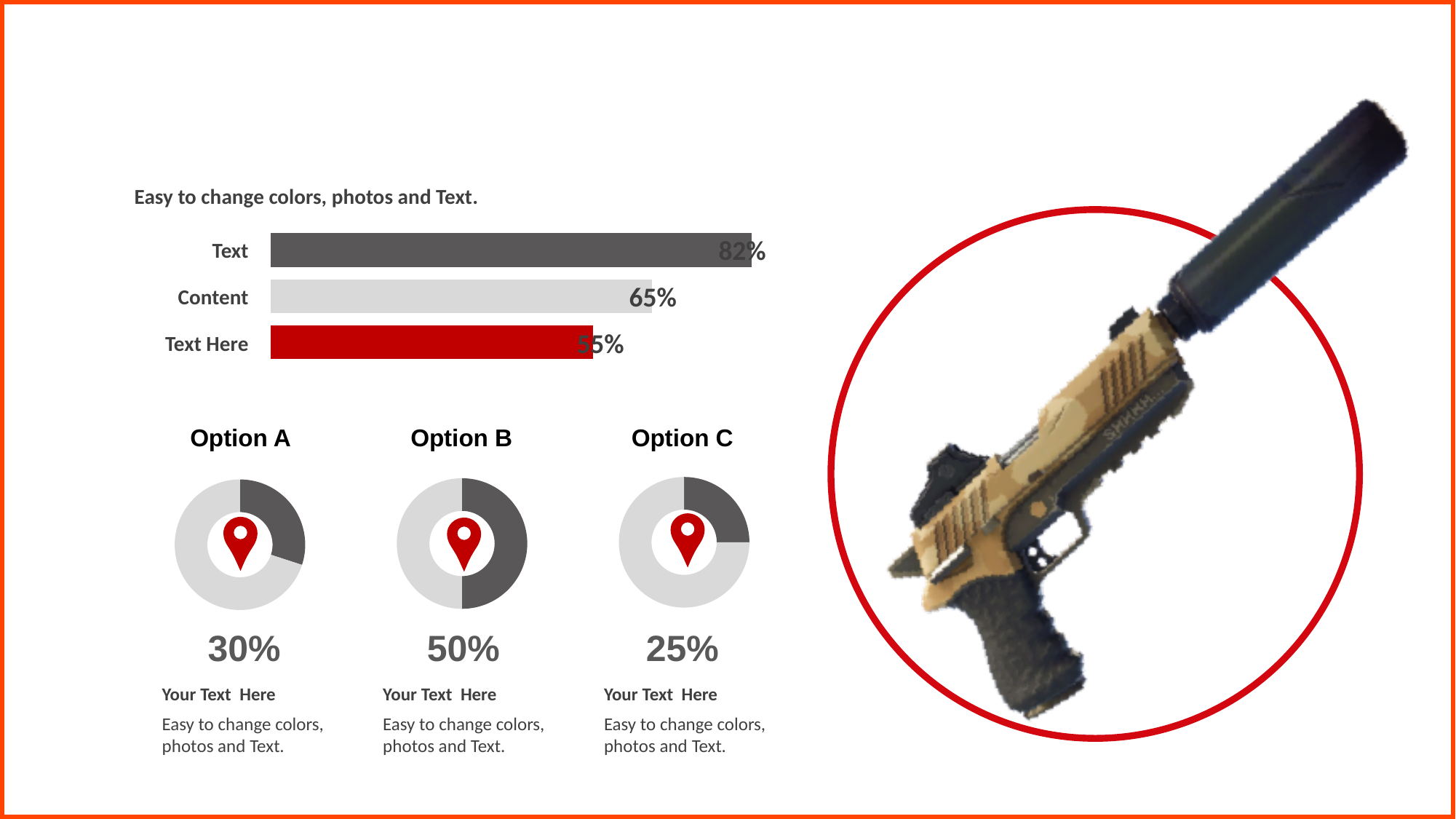
In the horizontal bar chart at the top left, what is the difference between the values for Text and Content? 17% In the horizontal bar chart at the top left, which category has the highest value? Text What percentage is shown for the Option B donut chart? 50% Which of the three donut charts (Option A, Option B, Option C) shows the lowest percentage? Option C In the horizontal bar chart at the top left, what is the value for Content? 65% What is the difference between the percentages shown for the Option A and Option C donut charts? 5% In the horizontal bar chart at the top left, which is larger, the value for Content or the value for Text Here? Content What kind of chart is the chart at the top left of the slide? Bar chart How many categories does the horizontal bar chart at the top left show? 3 In the horizontal bar chart at the top left, what colour is the bar for Text Here? Red In the horizontal bar chart at the top left, what is the value for Text Here? 55% In the horizontal bar chart at the top left, which category has the lowest value? Text Here